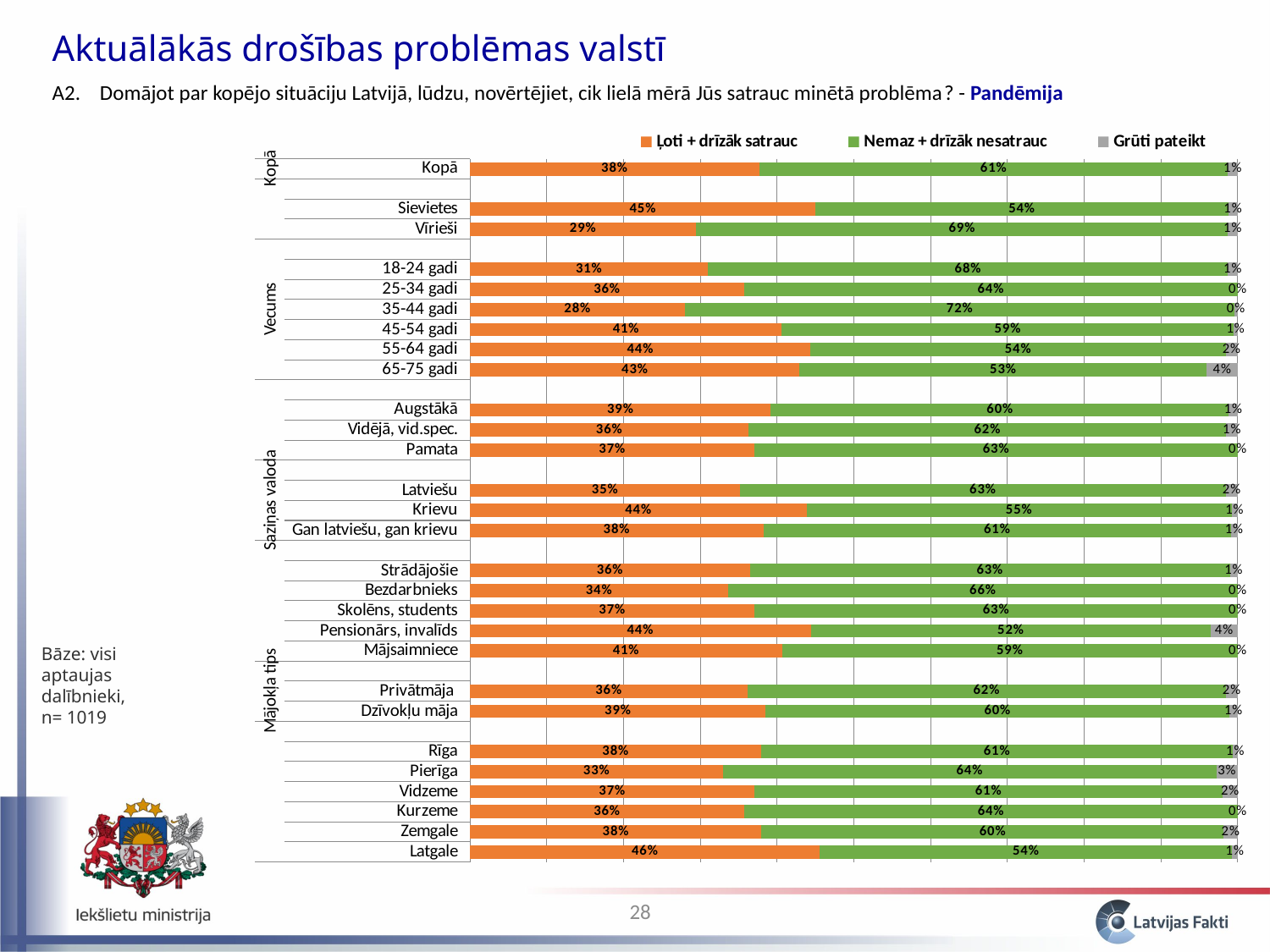
How many series does the legend list? 3 What is the difference between the "Ļoti + drīzāk satrauc" values for Sievietes and Vīrieši? 16 percentage points Which has a larger "Nemaz + drīzāk nesatrauc" value, Latviešu or Krievu? Latviešu What is the value of "Ļoti + drīzāk satrauc" for Kopā? 38% Which series is shown in green in the legend? Nemaz + drīzāk nesatrauc What is the value of "Grūti pateikt" for 65-75 gadi? 4% Which age group has the lowest "Ļoti + drīzāk satrauc" value? 35-44 gadi What is the value of "Nemaz + drīzāk nesatrauc" for Vīrieši? 69% What kind of chart is shown on the slide? Stacked bar chart What is the total of the three values shown for Pensionārs, invalīds? 100% Which region among Rīga, Pierīga, Vidzeme, Kurzeme, Zemgale and Latgale has the highest "Ļoti + drīzāk satrauc" value? Latgale What is the value of "Ļoti + drīzāk satrauc" for Pierīga? 33%